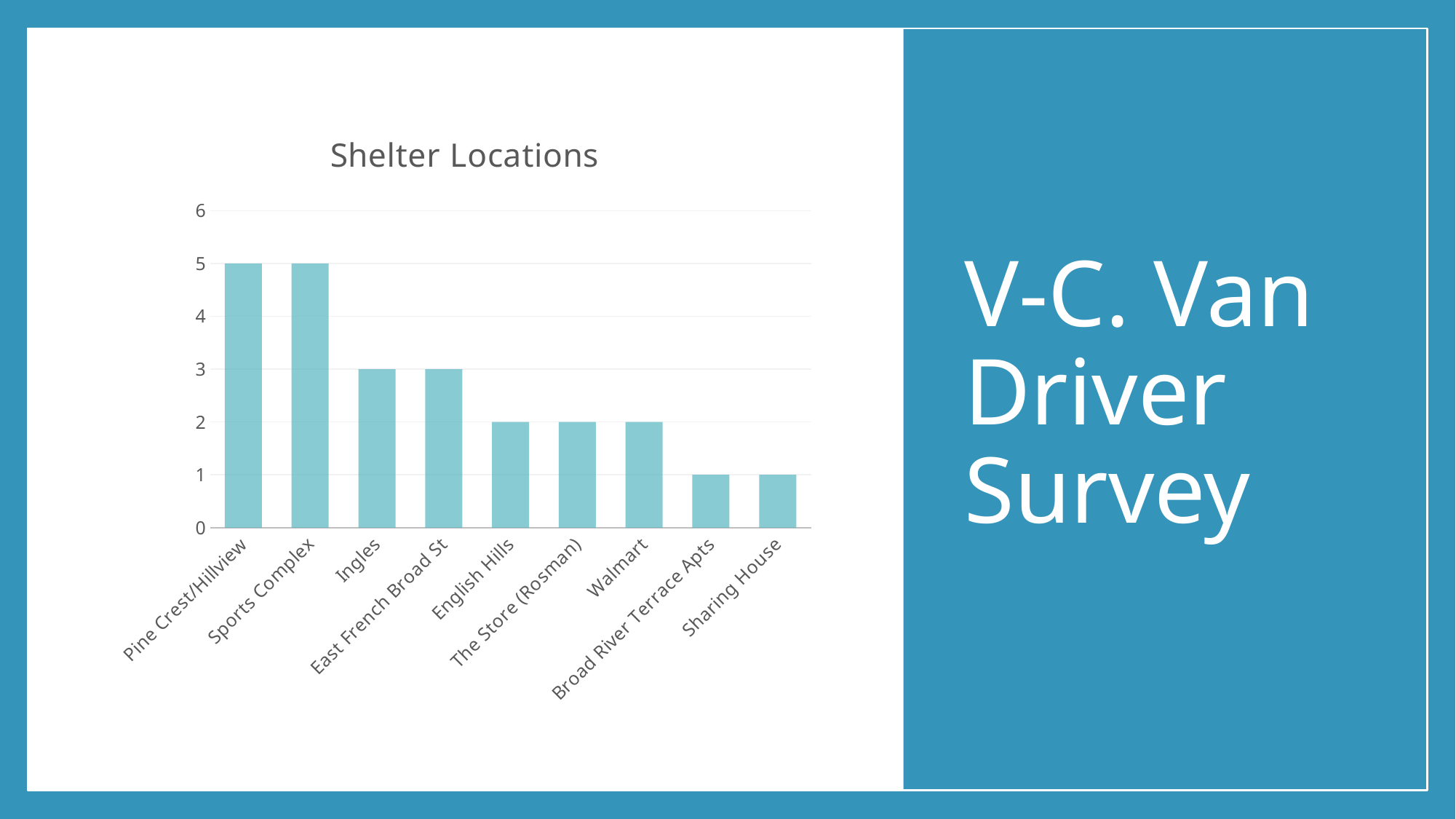
How many shelter locations are shown in the chart? 9 Which has a larger value, East French Broad St or Broad River Terrace Apts? East French Broad St What is the value for Sports Complex in the Shelter Locations chart? 5 What is the title of the chart on the slide? Shelter Locations Is the value for Pine Crest/Hillview greater or less than 4? greater What is the value for Sharing House in the Shelter Locations chart? 1 What is the difference between the values for Pine Crest/Hillview and English Hills? 3 What is the value for Ingles in the Shelter Locations chart? 3 What kind of chart is shown on the slide? Bar chart What is the value for Walmart in the Shelter Locations chart? 2 Which has a larger value, The Store (Rosman) or Sports Complex? Sports Complex Do the values generally rise or fall from left to right across the categories? Fall